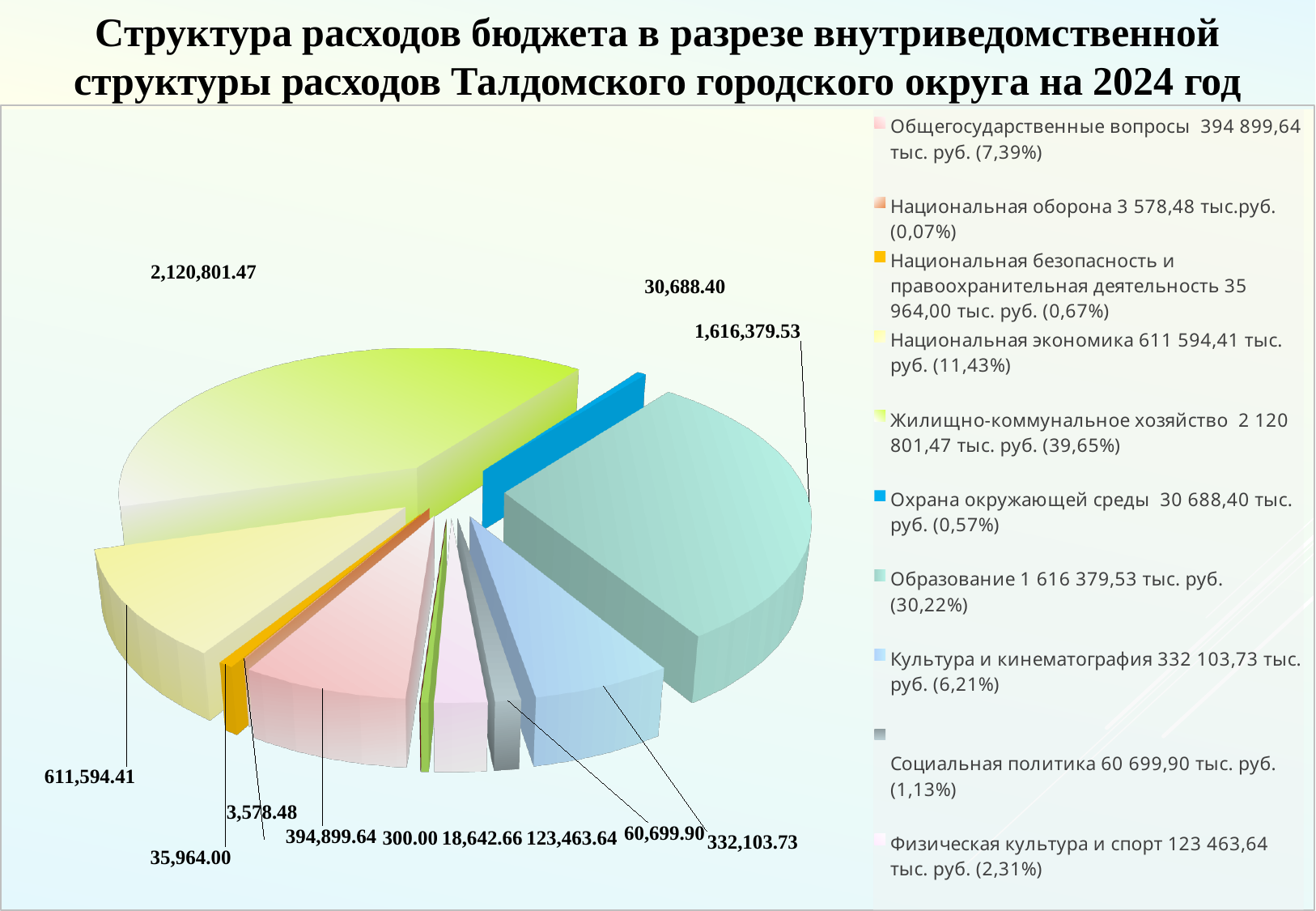
What is the value shown for Национальная экономика? 611,594.41 Which is larger, the value for Национальная экономика or the value for Культура и кинематография? Национальная экономика How many entries does the legend list? 10 What is the value shown for Жилищно-коммунальное хозяйство? 2,120,801.47 What share of the budget does Образование account for, according to the legend? 30,22% What kind of chart is shown on the slide? pie chart Which category has the largest slice of the pie? Жилищно-коммунальное хозяйство What is the value shown for Образование? 1,616,379.53 How many data labels are shown on the pie chart? 12 What is the value shown for Охрана окружающей среды? 30,688.40 What is the difference between the values for Жилищно-коммунальное хозяйство and Образование? 504,421.94 What is the smallest data label value shown on the pie chart? 300.00